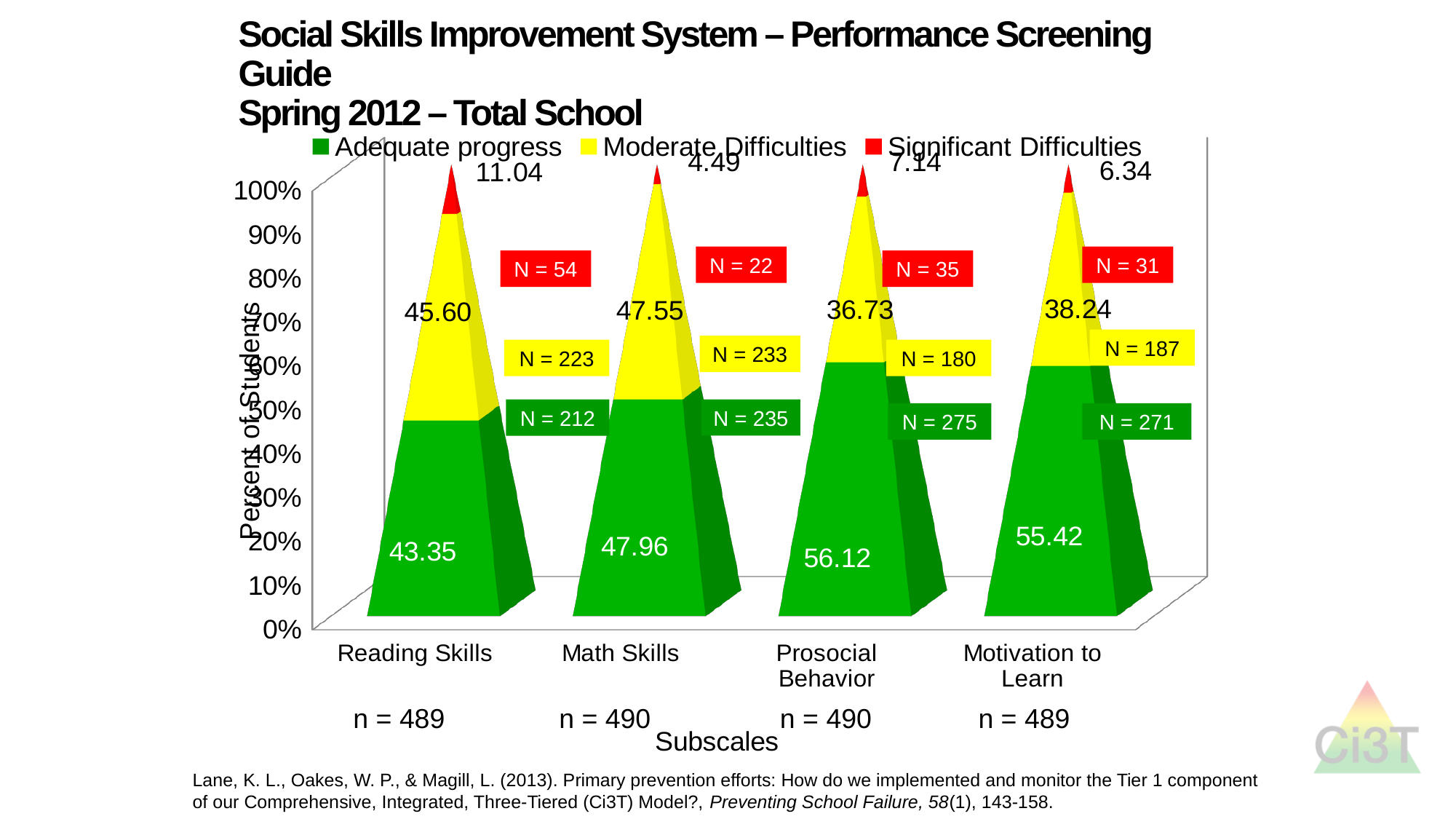
How many subscales are shown on the x axis? 4 What is the difference between the Adequate progress values for Prosocial Behavior and Reading Skills? 12.77 What is the Significant Difficulties value for Reading Skills? 11.04 Which subscale has the highest Significant Difficulties value? Reading Skills Which subscale has the lowest Significant Difficulties value? Math Skills Which subscale has the highest Adequate progress value? Prosocial Behavior What colour represents Significant Difficulties in the legend? Red How many series does the legend list? 3 What is the Moderate Difficulties value for Math Skills? 47.55 Which has the larger Moderate Difficulties value, Reading Skills or Motivation to Learn? Reading Skills What is the Moderate Difficulties value for Motivation to Learn? 38.24 What is the Adequate progress value for Prosocial Behavior? 56.12